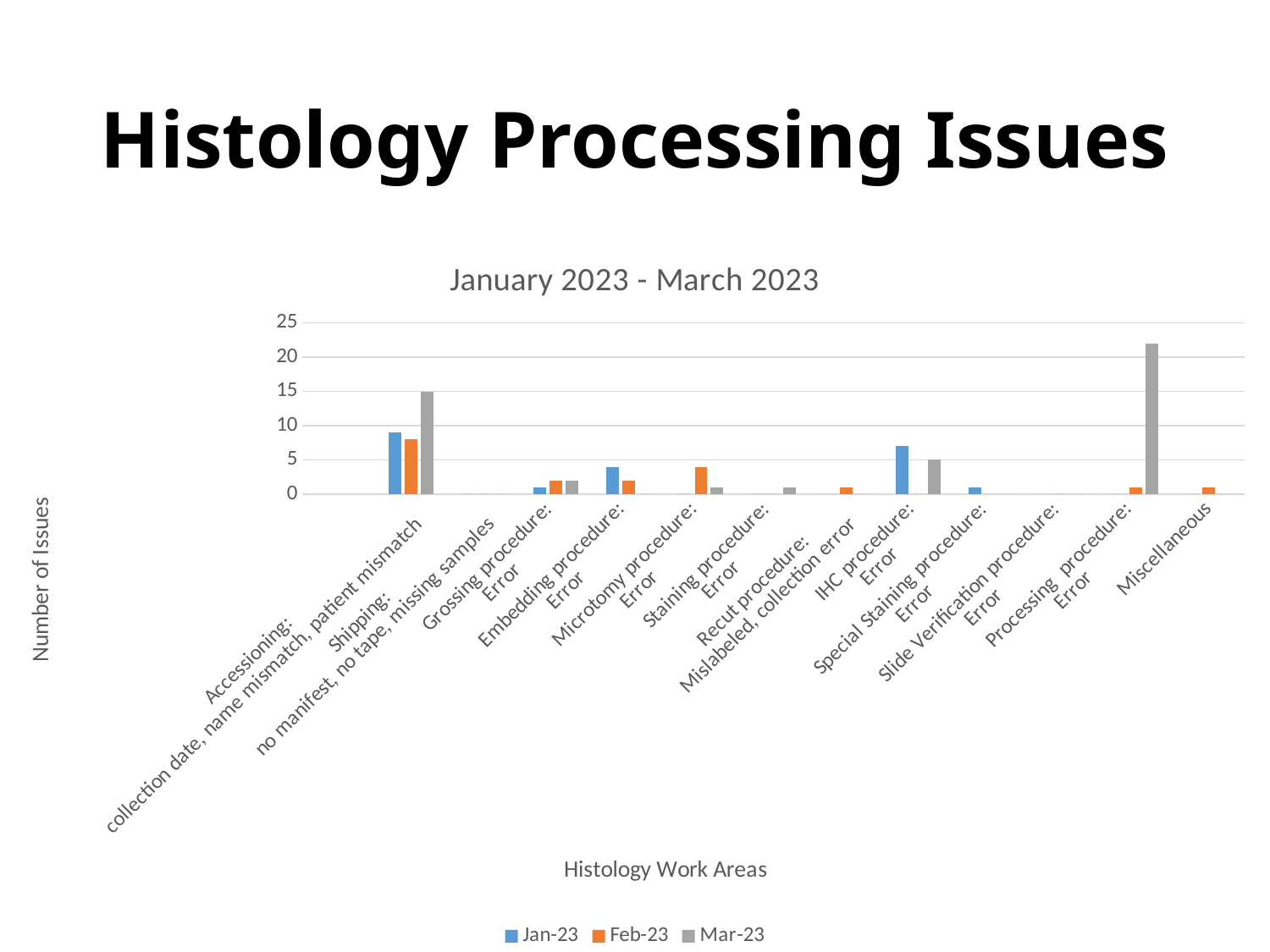
Which is larger for IHC procedure: Error: the Jan-23 value or the Mar-23 value? Jan-23 Is the Mar-23 value for Accessioning greater or less than 10? greater Which is larger for Accessioning: the Jan-23 value or the Mar-23 value? Mar-23 What kind of chart is shown on the slide? bar chart How many histology work area categories are shown on the x axis? 12 How many series does the legend list? 3 Is the Jan-23 value for IHC procedure: Error greater or less than 10? less Which histology work area has the highest Mar-23 value? Processing procedure: Error Is the Mar-23 value for Processing procedure: Error greater or less than 20? greater What is the title shown above the chart? January 2023 - March 2023 What is the label on the vertical axis of the chart? Number of Issues